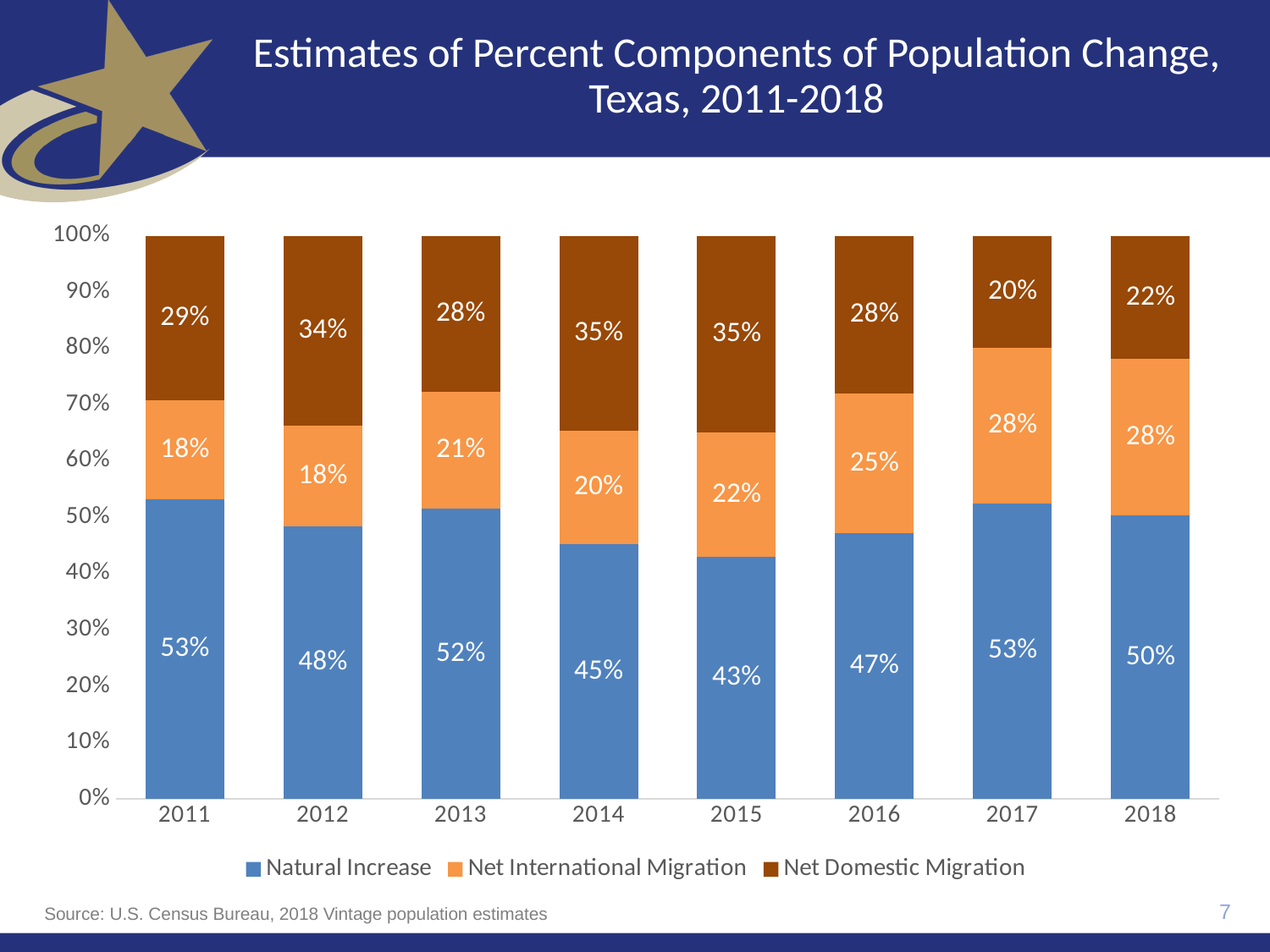
Which year has the lowest Natural Increase share? 2015 How many series does the legend list? 3 Which year has the lowest Net Domestic Migration share? 2017 What is the Net Domestic Migration value for 2012? 34% What is the Natural Increase value for 2015? 43% Does the Net International Migration share rise or fall from 2013 to 2017? Rise Which is larger, the Net International Migration value for 2013 or for 2017? 2017 What is the difference between the Net Domestic Migration values for 2014 and 2018? 13% How many years are shown on the x axis? 8 What is the Net International Migration value for 2016? 25% Which series is shown in dark brown in the legend? Net Domestic Migration What kind of chart is shown on the slide? Stacked bar chart